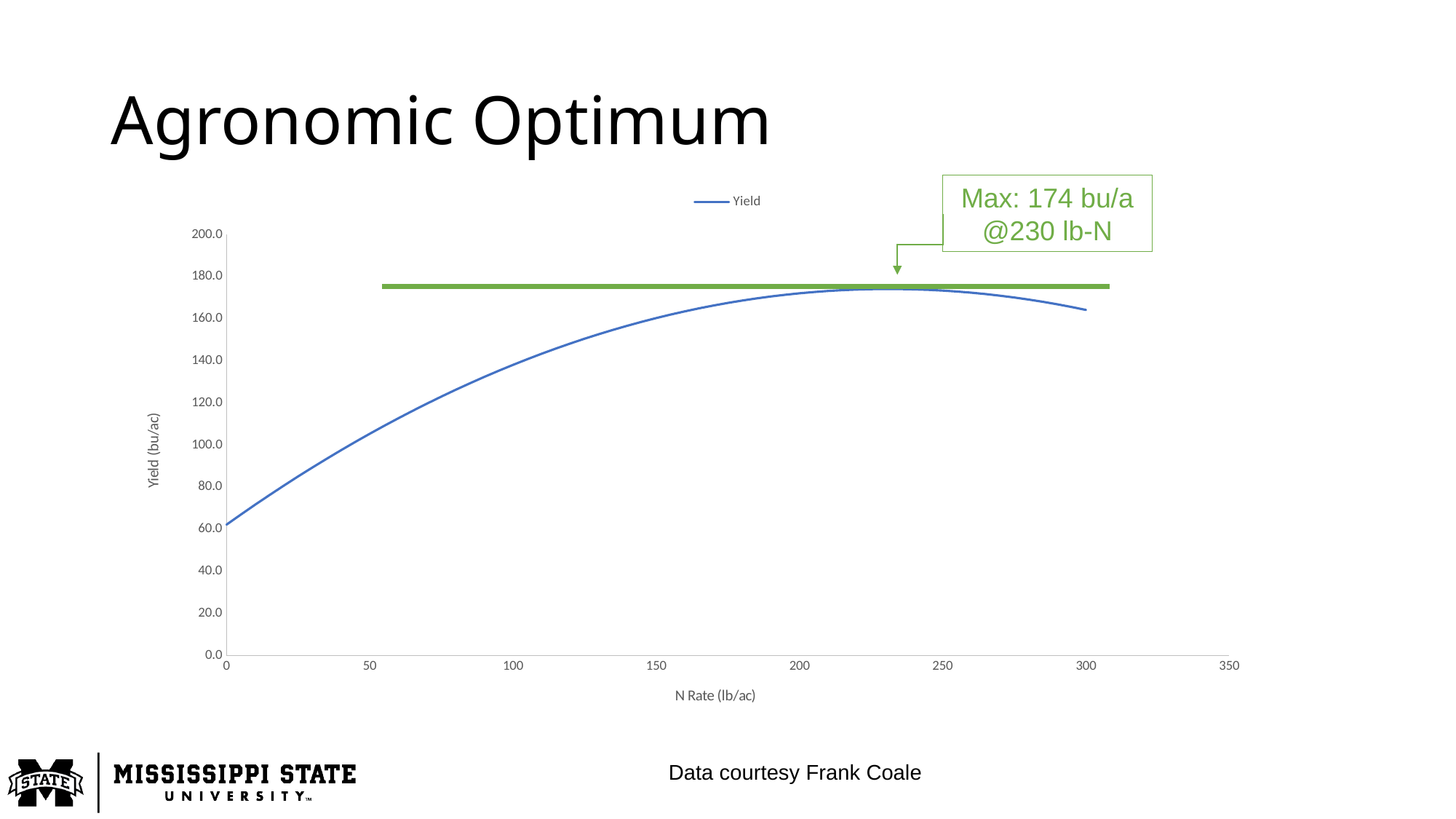
According to the annotation, at what N rate does the maximum yield occur? 230 lb-N Is the yield at an N rate of 0 greater or less than 80? less Does the yield rise or fall as the N rate increases from 0 to 200? rise Is the yield at an N rate of 0 greater or less than 40? greater How many series does the chart legend list? 1 What kind of chart is shown on the slide? line chart Is the yield at an N rate of 100 greater or less than 120? greater According to the annotation, what is the maximum yield shown on the chart? 174 bu/a What is the title of the x axis of the chart? N Rate (lb/ac) What is the name of the series shown in the chart legend? Yield